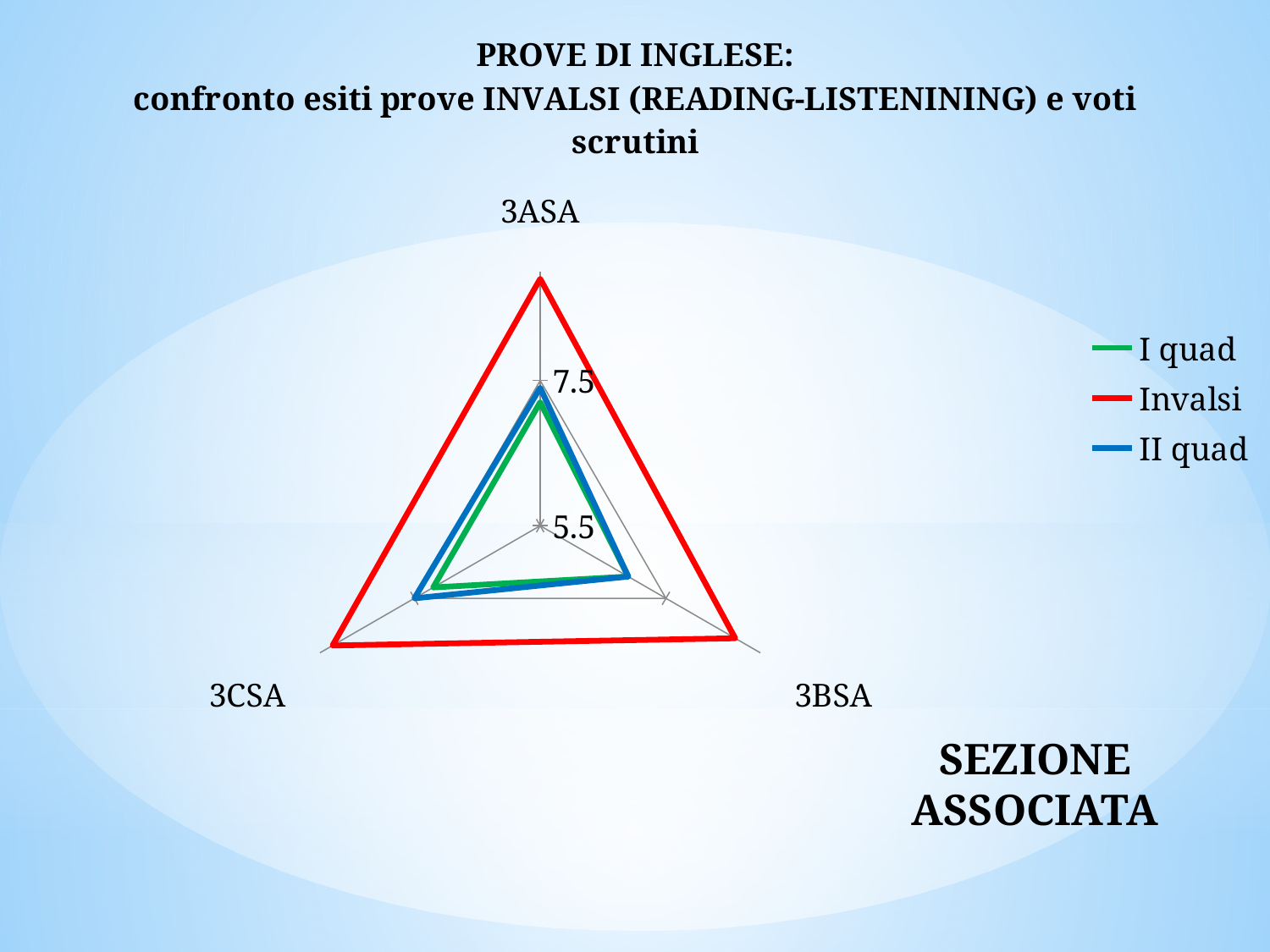
Is the Invalsi value for 3BSA greater or less than 7.5? greater Is the Invalsi value for 3ASA greater or less than 7.5? greater What kind of chart is shown on the slide? Radar chart Which series is shown in red in the legend? Invalsi Is the I quad value for 3BSA greater or less than 7.5? less For 3ASA, which is larger: the Invalsi value or the I quad value? Invalsi Which series is shown in green in the legend? I quad For 3BSA, which is larger: the II quad value or the Invalsi value? Invalsi How many series does the legend list? 3 How many categories (classes) are plotted on the radar chart? 3 Which series has the highest value for 3CSA? Invalsi